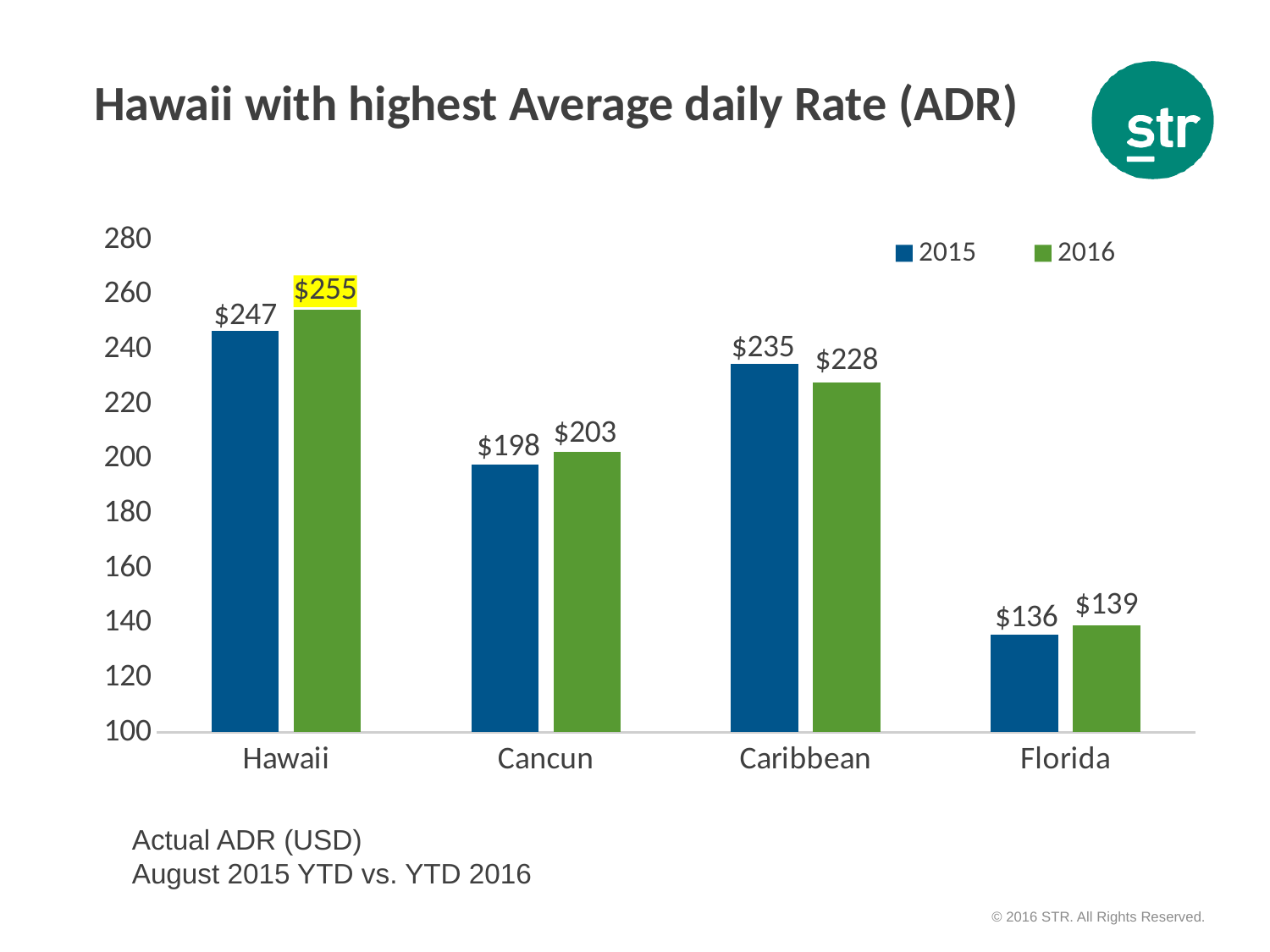
Which destination has the highest 2016 ADR? Hawaii How many destinations are shown on the x axis? 4 What is the 2016 ADR value for Caribbean? $228 What is the difference between the 2016 and 2015 ADR for Hawaii? $8 What is the difference between the 2015 and 2016 ADR for Caribbean? $7 What kind of chart is shown on the slide? bar chart How many series does the legend list? 2 What is the 2016 ADR value for Hawaii? $255 What is the 2015 ADR value for Cancun? $198 Which is larger, the 2015 ADR for Caribbean or the 2016 ADR for Caribbean? 2015 ADR for Caribbean Which destination has the lowest 2015 ADR? Florida Is the 2016 ADR value for Florida greater or less than 140? less